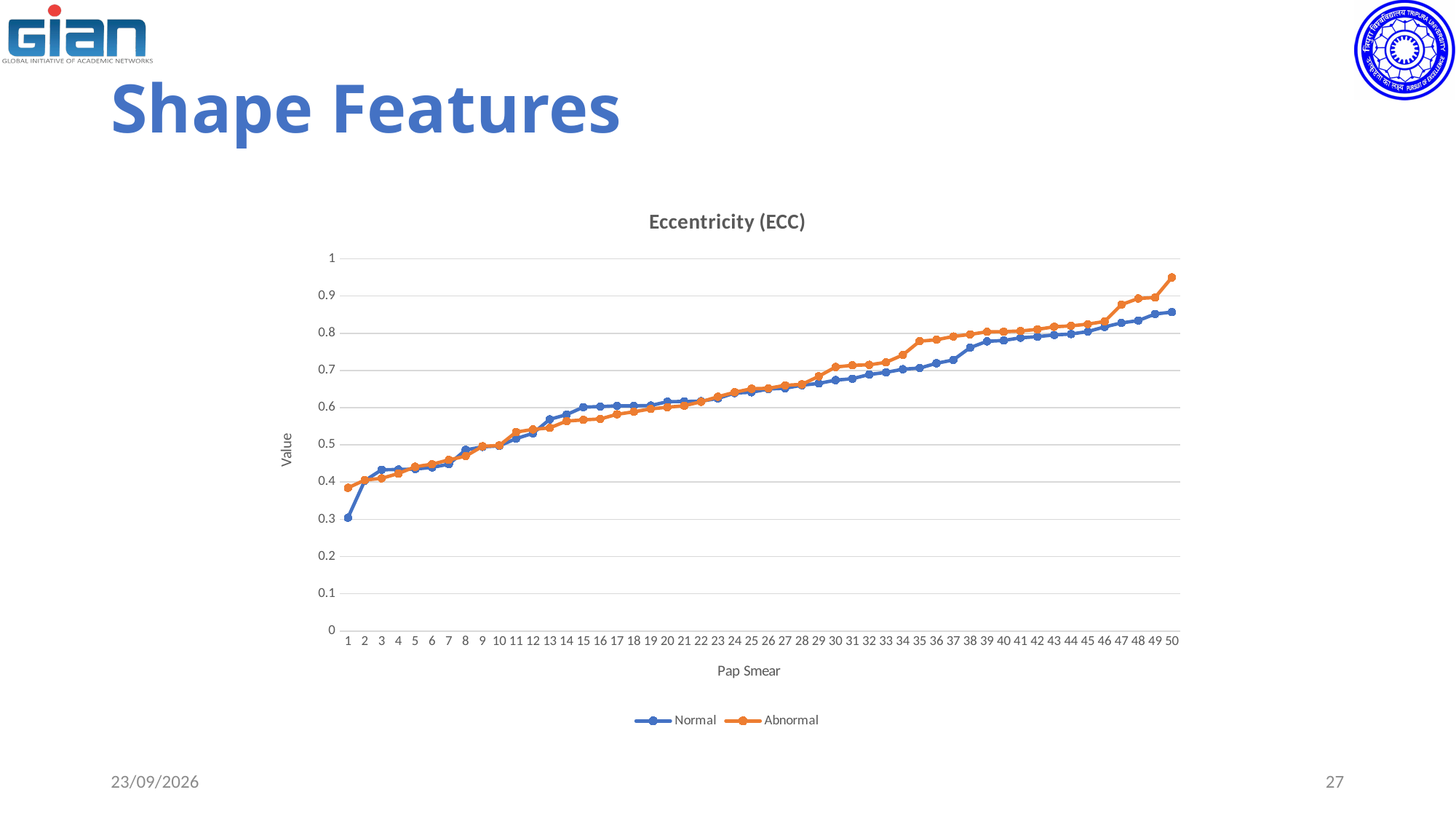
Is the Abnormal value at Pap Smear 20 greater or less than 0.7? less At Pap Smear 50, which series has the larger value, Normal or Abnormal? Abnormal What is the title of the chart? Eccentricity (ECC) At which Pap Smear number does the Normal series reach its lowest value? 1 How many series does the legend of the Eccentricity (ECC) chart list? 2 Which series is drawn in orange? Abnormal What kind of chart is shown on the slide? line chart Is the Normal value at Pap Smear 1 greater or less than 0.4? less Is the Abnormal value at Pap Smear 50 greater or less than 0.9? greater How many Pap Smear points are plotted along the x axis? 50 Do the values of the Normal series rise or fall as the Pap Smear number increases? rise